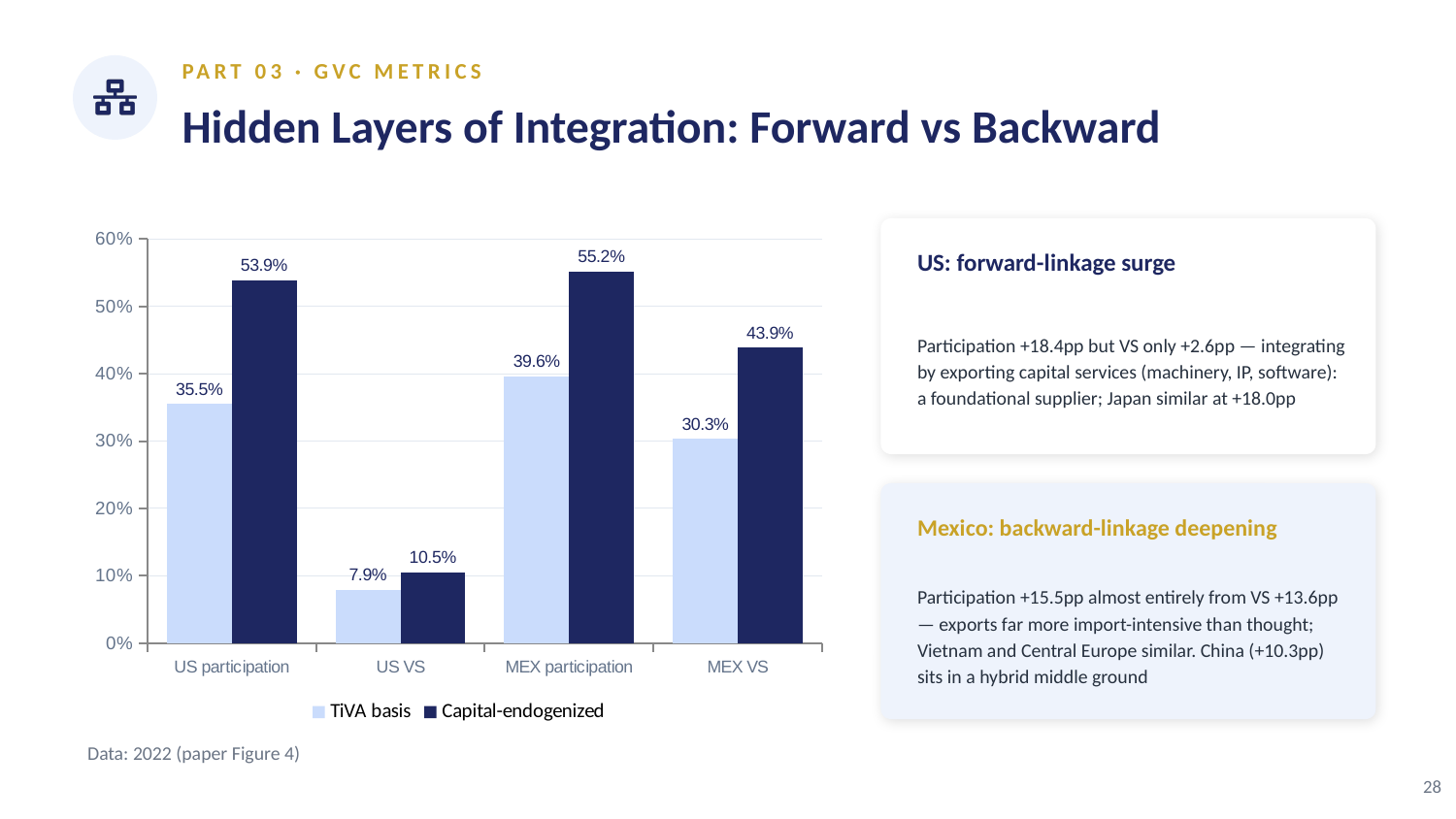
What kind of chart is shown on the slide? Bar chart What is the Capital-endogenized value for US VS? 10.5% What is the Capital-endogenized value for MEX VS? 43.9% Which category has the lowest TiVA basis value? US VS What is the difference between the Capital-endogenized and TiVA basis values for MEX VS? 13.6 percentage points Which category has the highest Capital-endogenized value? MEX participation What is the TiVA basis value for US participation? 35.5% How many series does the legend list? 2 Which series is shown in dark navy in the legend? Capital-endogenized What is the difference between the Capital-endogenized and TiVA basis values for US participation? 18.4 percentage points Which is larger: the TiVA basis value for MEX participation or the TiVA basis value for US participation? MEX participation How many categories are shown on the x axis? 4